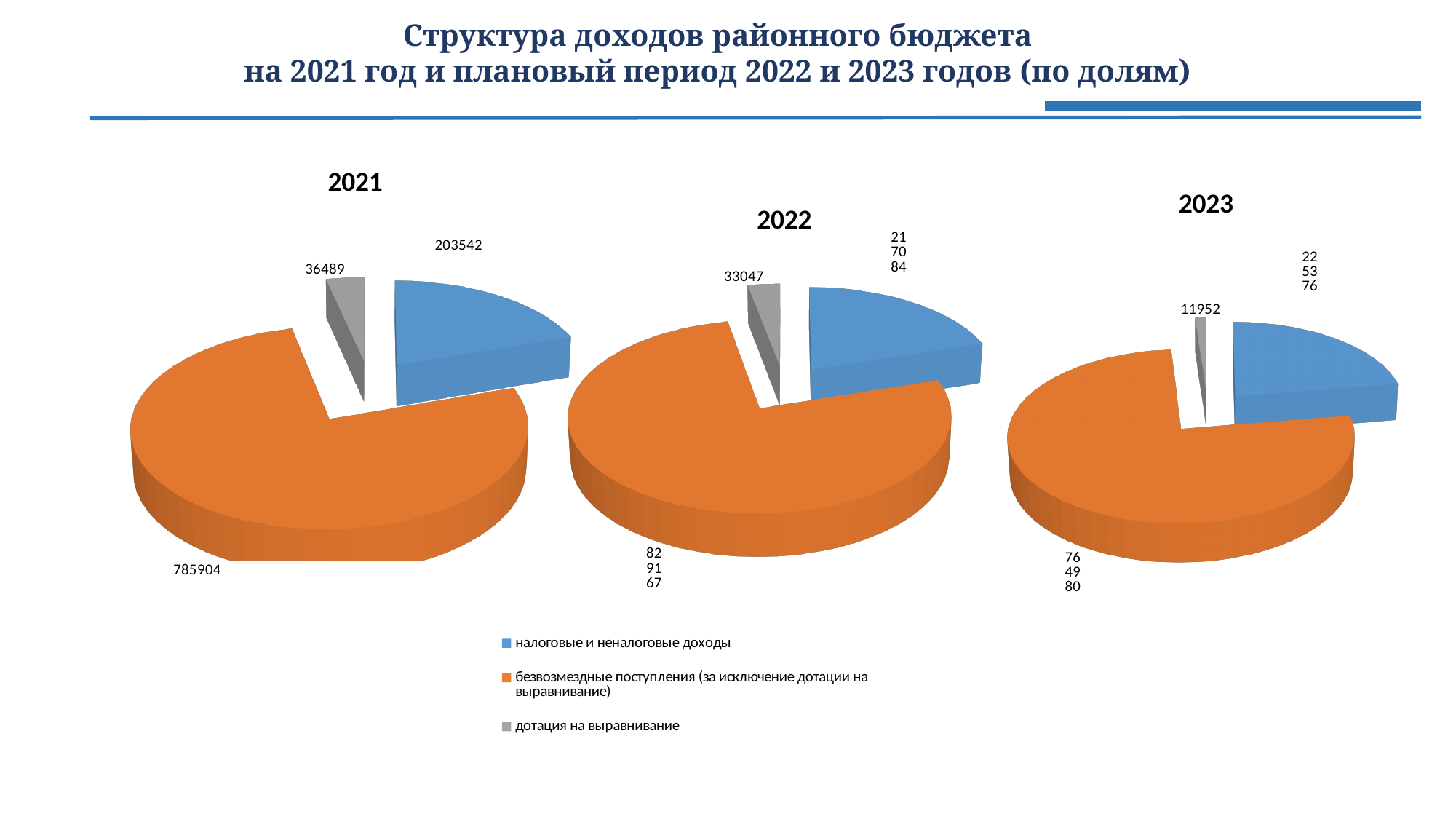
In the 2022 chart, what is the value for дотация на выравнивание? 33047 How many pie charts are shown on the slide? 3 In the 2021 chart, what is the difference between налоговые и неналоговые доходы and дотация на выравнивание? 167053 In the 2021 chart, what is the value for безвозмездные поступления (за исключение дотации на выравнивание)? 785904 Which is larger: дотация на выравнивание in the 2021 chart or in the 2022 chart? 2021 How many categories does the legend list? 3 In the 2023 chart, which category has the smallest slice? дотация на выравнивание In the 2023 chart, what is the value for дотация на выравнивание? 11952 In the 2021 chart, what is the value for дотация на выравнивание? 36489 What kind of chart is used for each of the three years on the slide? Pie chart In the 2021 chart, what is the value for налоговые и неналоговые доходы? 203542 In the 2021 chart, which category has the largest slice? безвозмездные поступления (за исключение дотации на выравнивание)